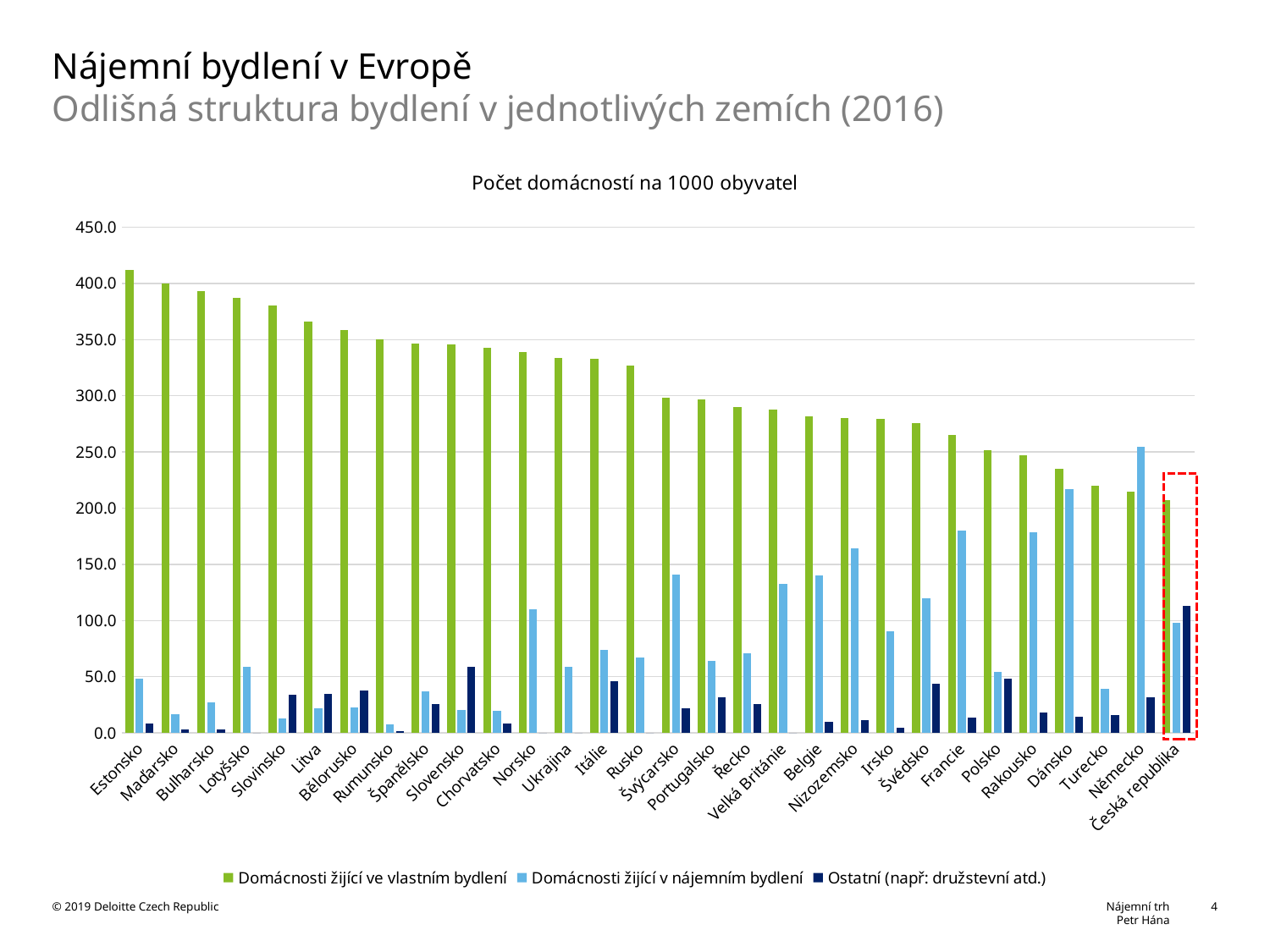
Which country has the highest value for 'Domácnosti žijící v nájemním bydlení'? Německo Do the values for 'Domácnosti žijící ve vlastním bydlení' rise or fall from left to right along the x axis? fall Which country has the highest value for 'Domácnosti žijící ve vlastním bydlení'? Estonsko Is the value for 'Domácnosti žijící v nájemním bydlení' in Německo greater or less than 200? greater Which country has the highest value for 'Ostatní (např: družstevní atd.)'? Česká republika How many series does the legend list? 3 Which has the larger value for 'Domácnosti žijící v nájemním bydlení', Německo or Rakousko? Německo Is the value for 'Domácnosti žijící ve vlastním bydlení' in Rusko greater or less than 350? less Is the value for 'Domácnosti žijící ve vlastním bydlení' in Estonsko greater or less than 400? greater How many countries are shown on the x axis? 30 What kind of chart is shown on the slide? bar chart